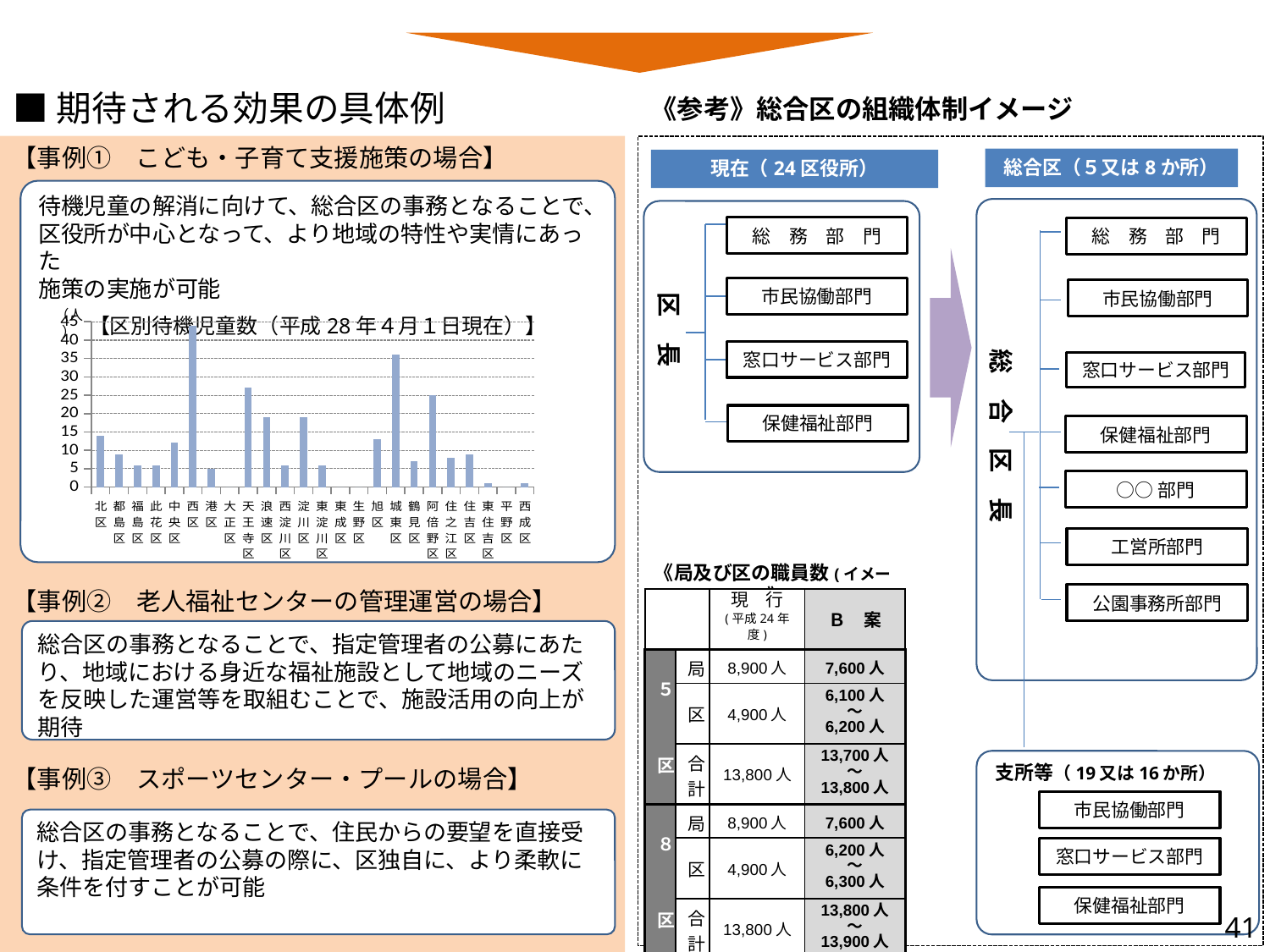
How many wards are shown on the x axis of the 区別待機児童数 chart? 24 In the 区別待機児童数 chart, is the value for 鶴見区 greater or less than 10? less What kind of chart is used to show 区別待機児童数（平成28年4月1日現在）? bar chart In the 区別待機児童数 chart, is the value for 西区 greater or less than 40? greater In the 区別待機児童数 chart, which has more waiting children, 西区 or 城東区? 西区 What is the title of the bar chart on the slide? 【区別待機児童数（平成28年4月1日現在）】 In the 区別待機児童数 chart, is the value for 阿倍野区 greater or less than 20? greater In the 区別待機児童数 chart, which has more waiting children, 北区 or 都島区? 北区 In the 区別待機児童数 chart, which ward has the highest number of waiting children? 西区 In the 区別待機児童数 chart, which has more waiting children, 城東区 or 天王寺区? 城東区